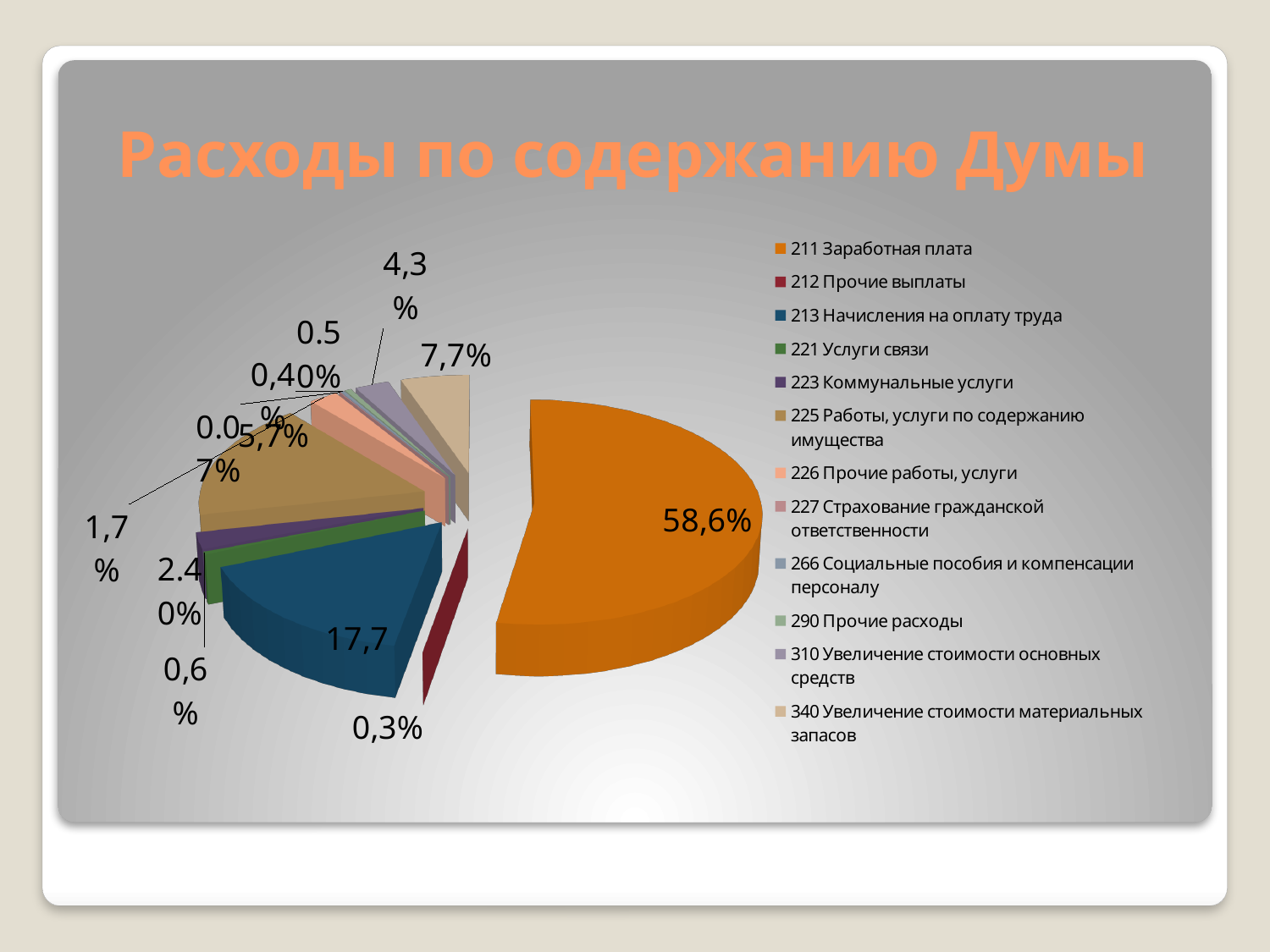
What colour is the slice for 211 Заработная плата? orange What value is shown for 340 Увеличение стоимости материальных запасов? 7,7% What is the title of the chart? Расходы по содержанию Думы Which is larger: the slice for 213 Начисления на оплату труда or the slice for 212 Прочие выплаты? 213 Начисления на оплату труда How many entries does the chart legend list? 12 Is the share for 211 Заработная плата greater or less than 50%? greater What value is shown for 213 Начисления на оплату труда? 17,7 Which is larger: the slice for 211 Заработная плата or the slice for 213 Начисления на оплату труда? 211 Заработная плата What share of the pie does 211 Заработная плата take? 58,6% What kind of chart is shown on the slide? pie chart Which category has the largest slice of the pie? 211 Заработная плата What value is shown for 212 Прочие выплаты? 0,3%